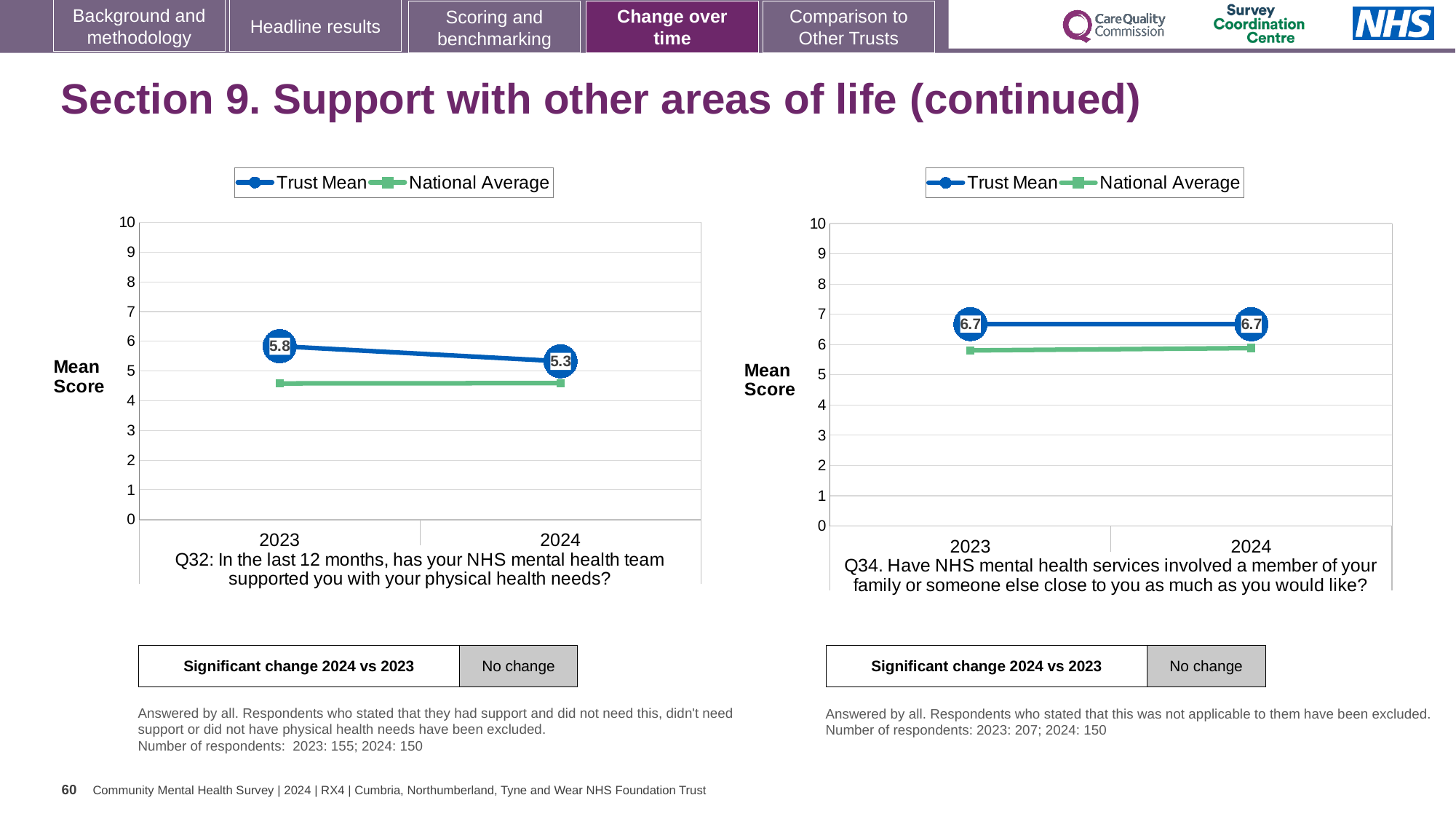
In the right chart (Q34), what is the Trust Mean score for 2024? 6.7 How many series does the legend of the right chart (Q34) list? 2 In the left chart (Q32), what is the Trust Mean score for 2024? 5.3 In the right chart (Q34), does the Trust Mean rise, fall or stay the same from 2023 to 2024? stay the same What kind of chart is the left chart (Q32)? line chart In the left chart (Q32), is the National Average value for 2023 greater or less than 5? less How many years are plotted on the x axis of the left chart (Q32)? 2 In the left chart (Q32), what is the Trust Mean score for 2023? 5.8 In the left chart (Q32), by how much did the Trust Mean change from 2023 to 2024? 0.5 In the right chart (Q34), which series has the higher value in 2023, Trust Mean or National Average? Trust Mean In the left chart (Q32), does the Trust Mean rise or fall from 2023 to 2024? fall What is the label on the y axis of the right chart (Q34)? Mean Score